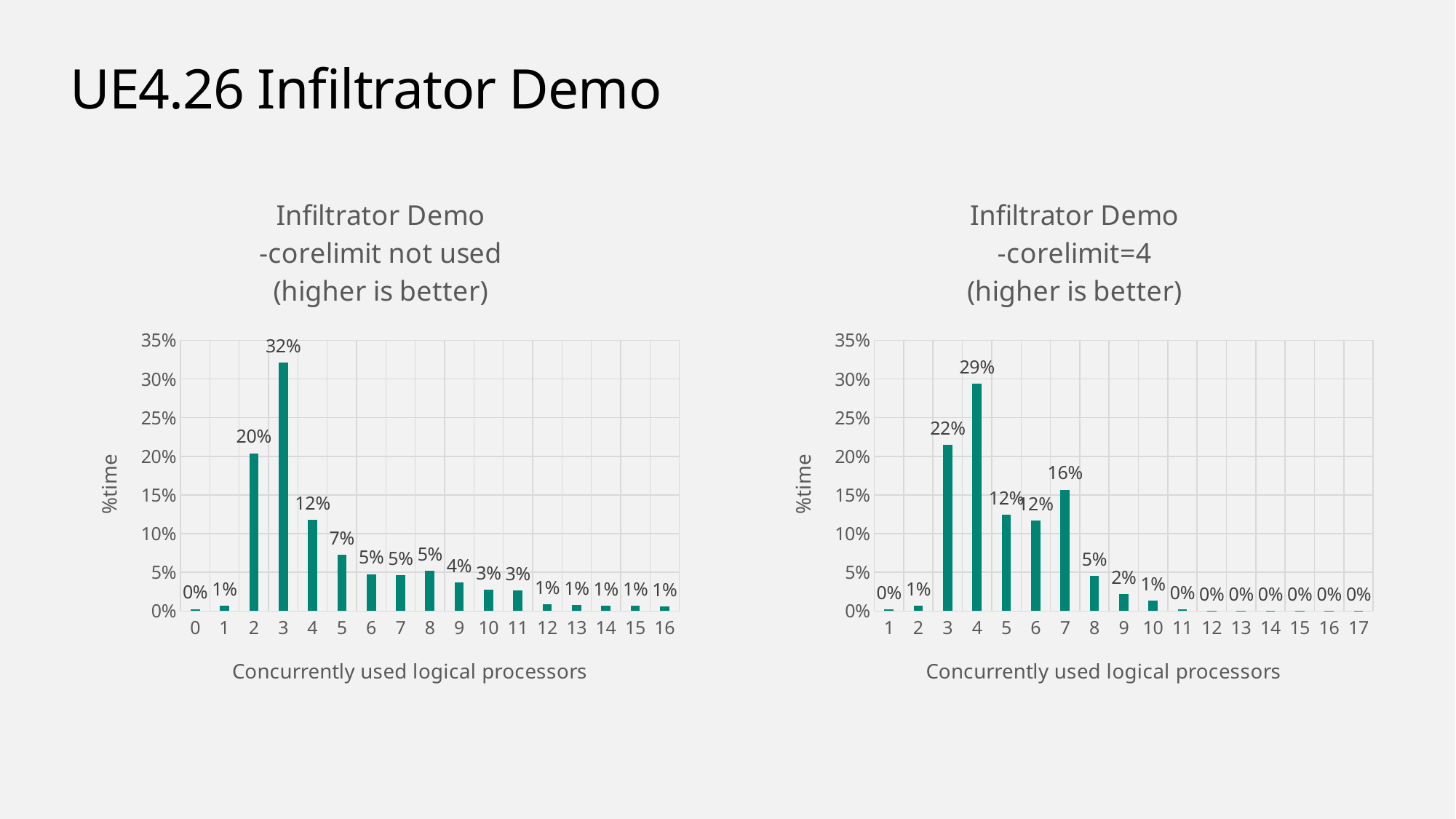
In the '-corelimit not used' chart, is the value for 2 concurrently used logical processors greater or less than 15%? greater In the '-corelimit=4' chart, which number of concurrently used logical processors has the highest %time? 4 In the '-corelimit=4' chart, do the values rise or fall from 7 to 11 concurrently used logical processors? fall In the '-corelimit=4' chart, what is the difference in %time between 4 and 3 concurrently used logical processors? 7% In the '-corelimit not used' chart, which number of concurrently used logical processors has the highest %time? 3 What kind of chart is the '-corelimit=4' chart? bar chart In the '-corelimit=4' chart, which has a higher %time: 7 or 8 concurrently used logical processors? 7 In the '-corelimit not used' chart, what is the %time for 3 concurrently used logical processors? 32% In the '-corelimit not used' chart, what is the difference in %time between 3 and 2 concurrently used logical processors? 12% How many categories are shown on the x axis of the '-corelimit not used' chart? 17 In the '-corelimit=4' chart, what is the %time for 7 concurrently used logical processors? 16% What is the x-axis label of the left chart? Concurrently used logical processors